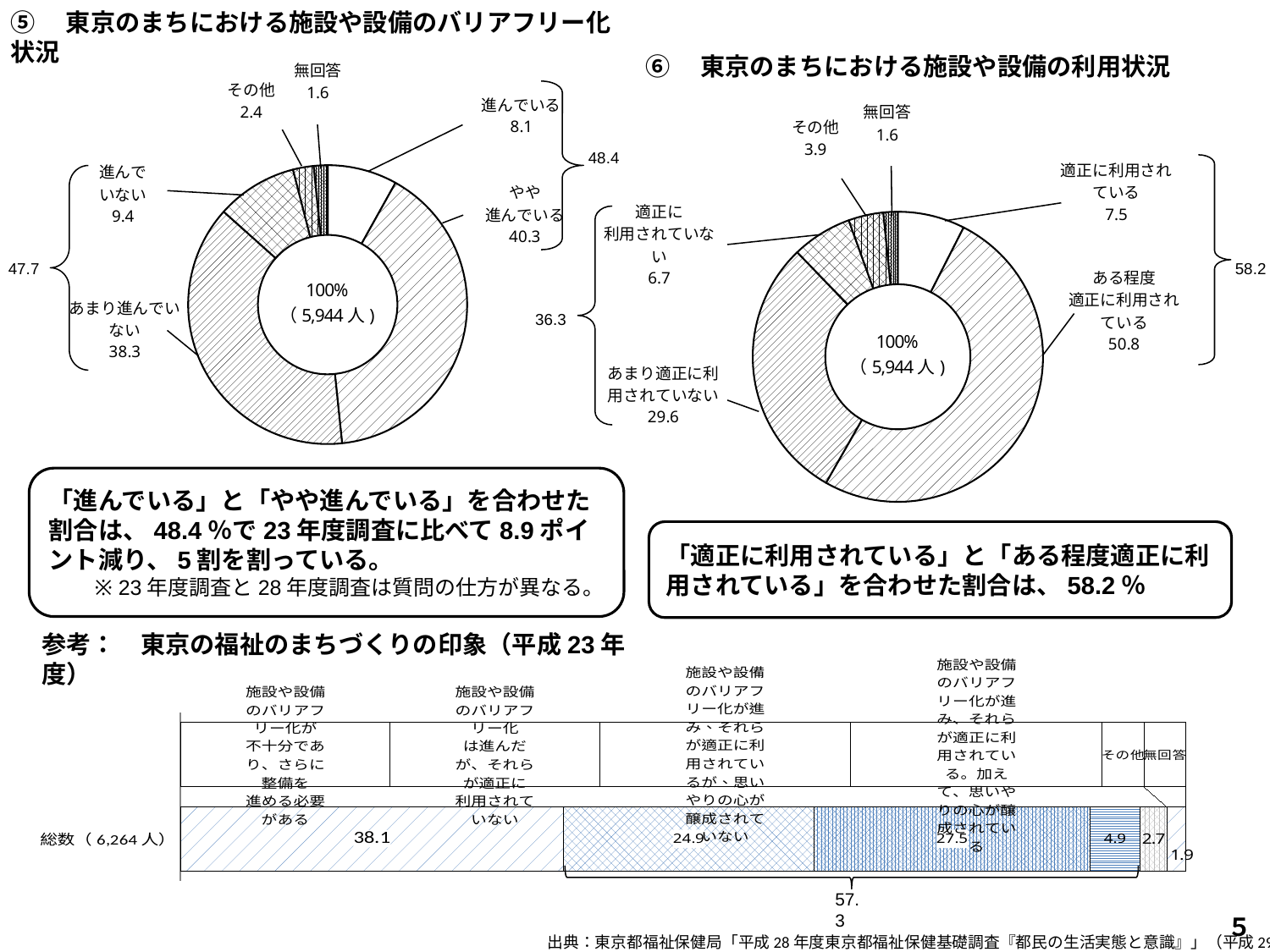
In the bottom chart (東京の福祉のまちづくりの印象（平成23年度）), what is the value for 「その他」? 2.7 In chart ⑥ (東京のまちにおける施設や設備の利用状況), what is the value for 「ある程度適正に利用されている」? 50.8 In chart ⑥ (東京のまちにおける施設や設備の利用状況), which is larger: 「適正に利用されている」 or 「適正に利用されていない」? 適正に利用されている What kind of chart is the bottom chart (東京の福祉のまちづくりの印象（平成23年度）)? Stacked bar chart In chart ⑤ (東京のまちにおける施設や設備のバリアフリー化状況), which category has the smallest share? 無回答 In chart ⑤ (東京のまちにおける施設や設備のバリアフリー化状況), what is the value for 「やや進んでいる」? 40.3 In chart ⑤ (東京のまちにおける施設や設備のバリアフリー化状況), how many respondents does the 100% represent? 5,944人 In chart ⑥ (東京のまちにおける施設や設備の利用状況), which category has the largest share? ある程度適正に利用されている In chart ⑤ (東京のまちにおける施設や設備のバリアフリー化状況), what is the difference between 「あまり進んでいない」 and 「進んでいない」? 28.9 In chart ⑥ (東京のまちにおける施設や設備の利用状況), how many categories are shown? 6 In the bottom chart (東京の福祉のまちづくりの印象（平成23年度）), what is the largest segment value? 38.1 What kind of chart is chart ⑥ (東京のまちにおける施設や設備の利用状況)? Donut (pie) chart